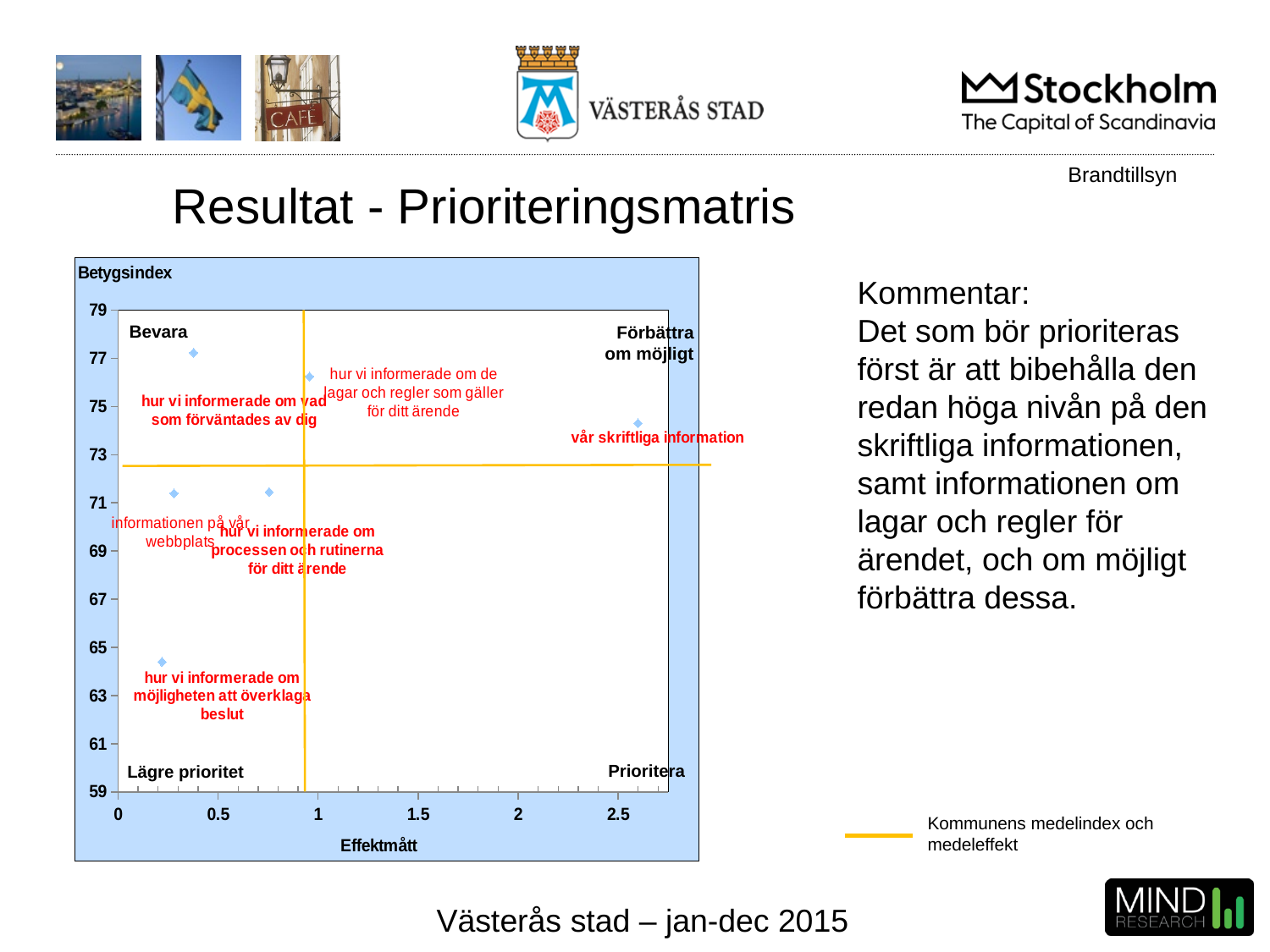
Is the Betygsindex for 'informationen på vår webbplats' greater or less than 69? greater Which point has the highest Effektmått? vår skriftliga information What do the yellow lines in the chart represent, according to the legend? Kommunens medelindex och medeleffekt What kind of chart is shown on the slide? Scatter plot Is the Betygsindex for 'vår skriftliga information' greater or less than 73? greater Which has a higher Effektmått: 'hur vi informerade om processen och rutinerna för ditt ärende' or 'informationen på vår webbplats'? hur vi informerade om processen och rutinerna för ditt ärende Which point has the lowest Betygsindex? hur vi informerade om möjligheten att överklaga beslut What is the label of the horizontal axis? Effektmått Is the Betygsindex for 'hur vi informerade om möjligheten att överklaga beslut' greater or less than 67? less How many data points are plotted in the chart? 6 Which point has the highest Betygsindex? hur vi informerade om vad som förväntades av dig